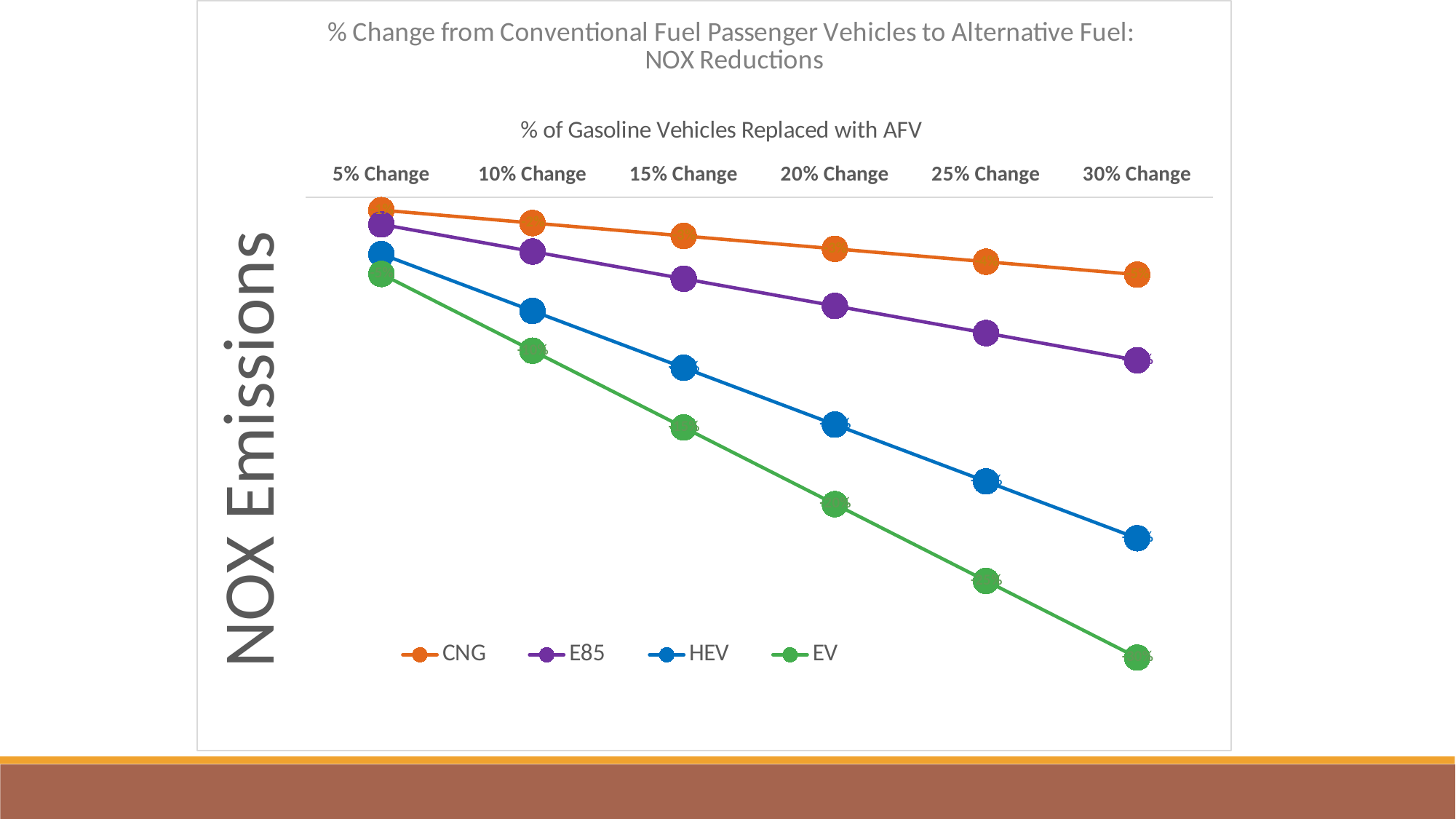
Do the values for the EV series rise or fall as the x axis moves from 5% Change to 30% Change? fall At 30% Change, which series has the lowest value? EV Which series shows the steepest decline across the x axis? EV At 20% Change, which is larger, the value for E85 or the value for HEV? E85 How many categories are shown along the x axis? 6 What kind of chart is shown on the slide? line chart Which series does the legend list first? CNG How many series does the legend list? 4 At 25% Change, which is larger, the value for HEV or the value for EV? HEV Do the values for the CNG series rise or fall along the x axis? fall At 30% Change, which series has the highest value? CNG What is the label of the y axis? NOX Emissions